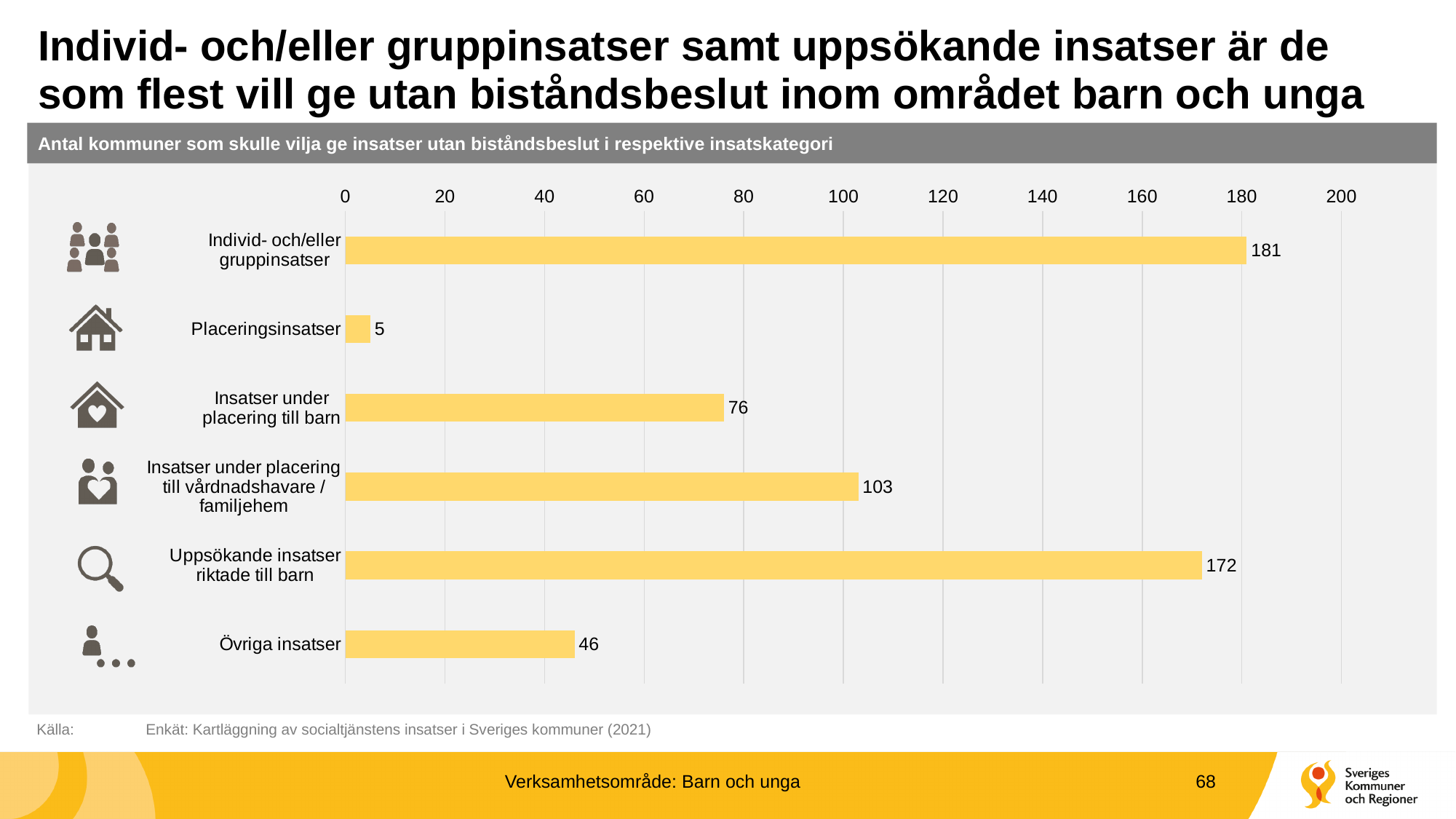
What is the difference between the values for Individ- och/eller gruppinsatser and Uppsökande insatser riktade till barn? 9 Which category has the highest value? Individ- och/eller gruppinsatser What is the value for Placeringsinsatser? 5 What is the value for Övriga insatser? 46 What is the value for Individ- och/eller gruppinsatser? 181 Which is larger, the value for Insatser under placering till barn or the value for Övriga insatser? Insatser under placering till barn What is the value for Insatser under placering till vårdnadshavare / familjehem? 103 Which category has the lowest value? Placeringsinsatser What is the value for Insatser under placering till barn? 76 What is the value for Uppsökande insatser riktade till barn? 172 How many categories are shown in the chart? 6 What kind of chart is shown on the slide? Bar chart